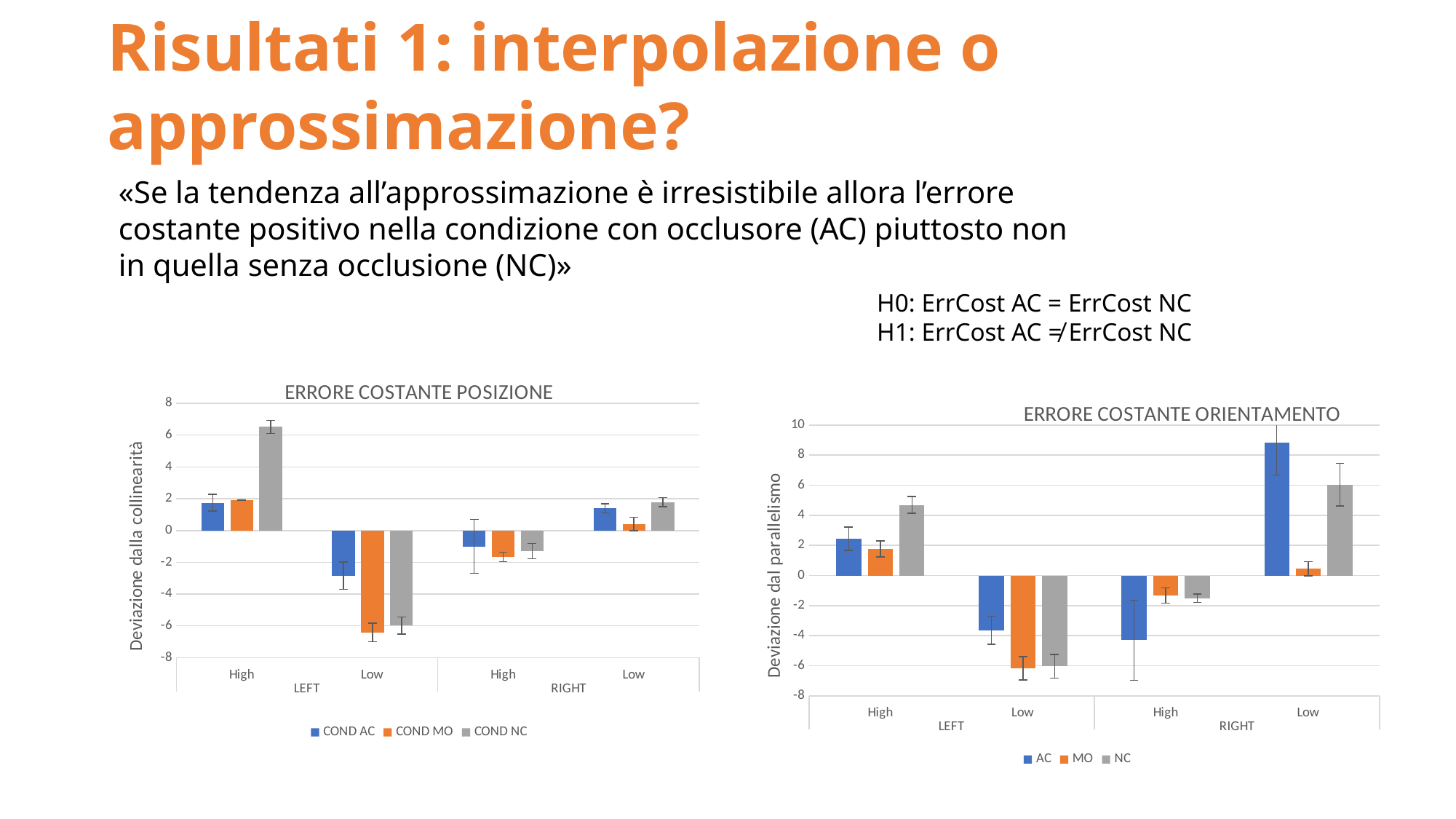
In the ERRORE COSTANTE ORIENTAMENTO chart, is the value for AC at RIGHT Low greater or less than 6? greater In the ERRORE COSTANTE POSIZIONE chart, is the value for COND NC at LEFT High greater or less than 4? greater In the ERRORE COSTANTE POSIZIONE chart, which bar is the highest overall? COND NC at LEFT High How many category groups (High/Low combinations) are shown on the x axis of the ERRORE COSTANTE POSIZIONE chart? 4 What kind of chart is the ERRORE COSTANTE POSIZIONE chart? bar chart In the ERRORE COSTANTE POSIZIONE chart, is the value for COND MO at LEFT Low greater or less than -4? less In the ERRORE COSTANTE ORIENTAMENTO chart, at LEFT High, which is larger: NC or AC? NC How many series does the legend of the ERRORE COSTANTE POSIZIONE chart list? 3 How many series does the legend of the ERRORE COSTANTE ORIENTAMENTO chart list? 3 What is the y-axis title of the ERRORE COSTANTE POSIZIONE chart? Deviazione dalla collinearità In the ERRORE COSTANTE ORIENTAMENTO chart, which bar is the highest overall? AC at RIGHT Low In the ERRORE COSTANTE POSIZIONE chart, at LEFT High, which is larger: COND NC or COND AC? COND NC